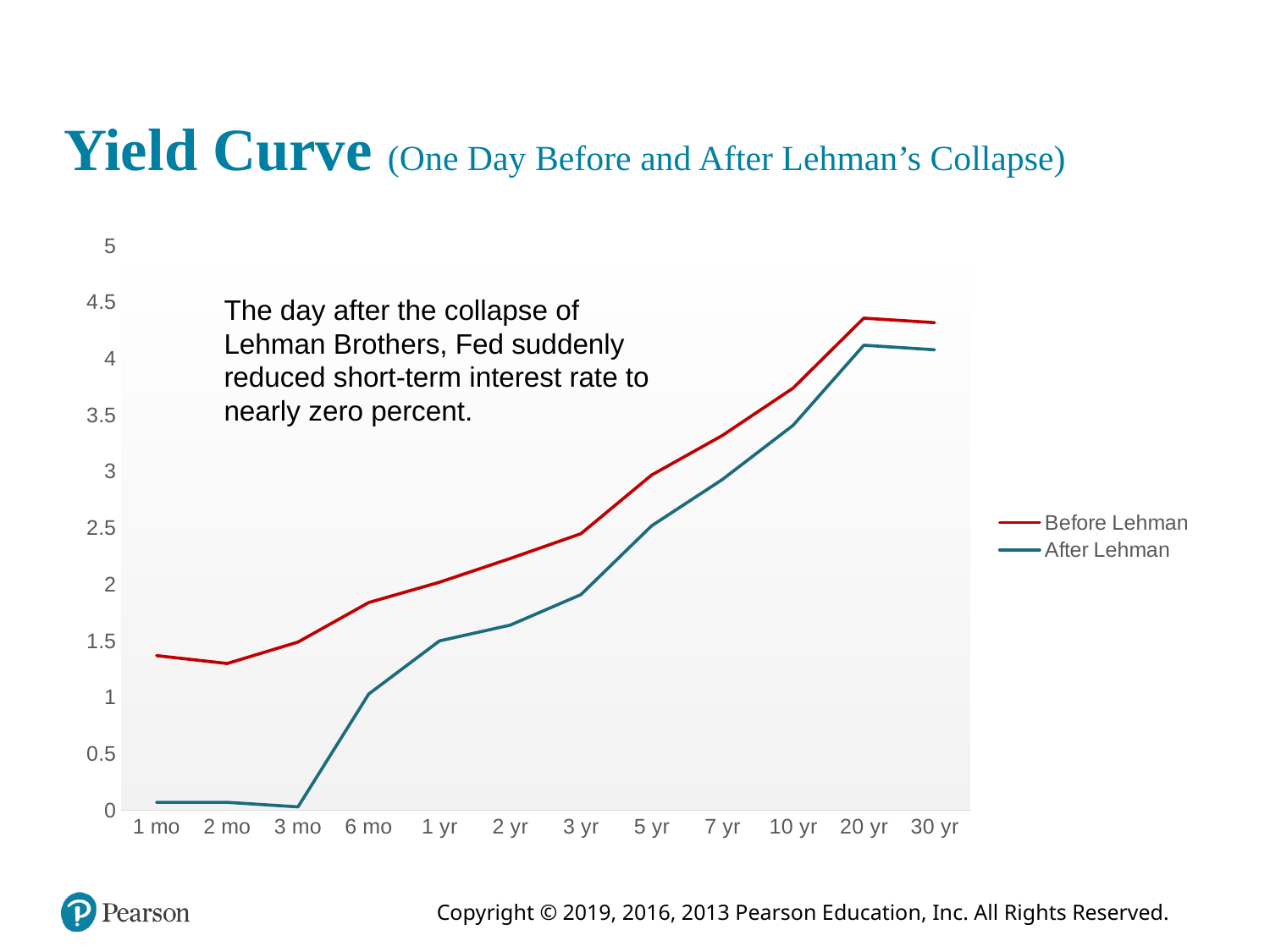
Is the Before Lehman value at 20 yr greater or less than 4? greater Is the After Lehman value at 1 mo greater or less than 0.5? less Is the After Lehman value at 3 yr greater or less than 2? less What kind of chart is shown on the slide? line chart Which series is drawn in red? Before Lehman How many maturities are plotted along the x axis? 12 At 6 mo, which series has the higher value, Before Lehman or After Lehman? Before Lehman How many series does the legend list? 2 What are the two series named in the legend? Before Lehman, After Lehman Do the After Lehman values generally rise or fall as maturity increases from 1 mo to 30 yr? rise